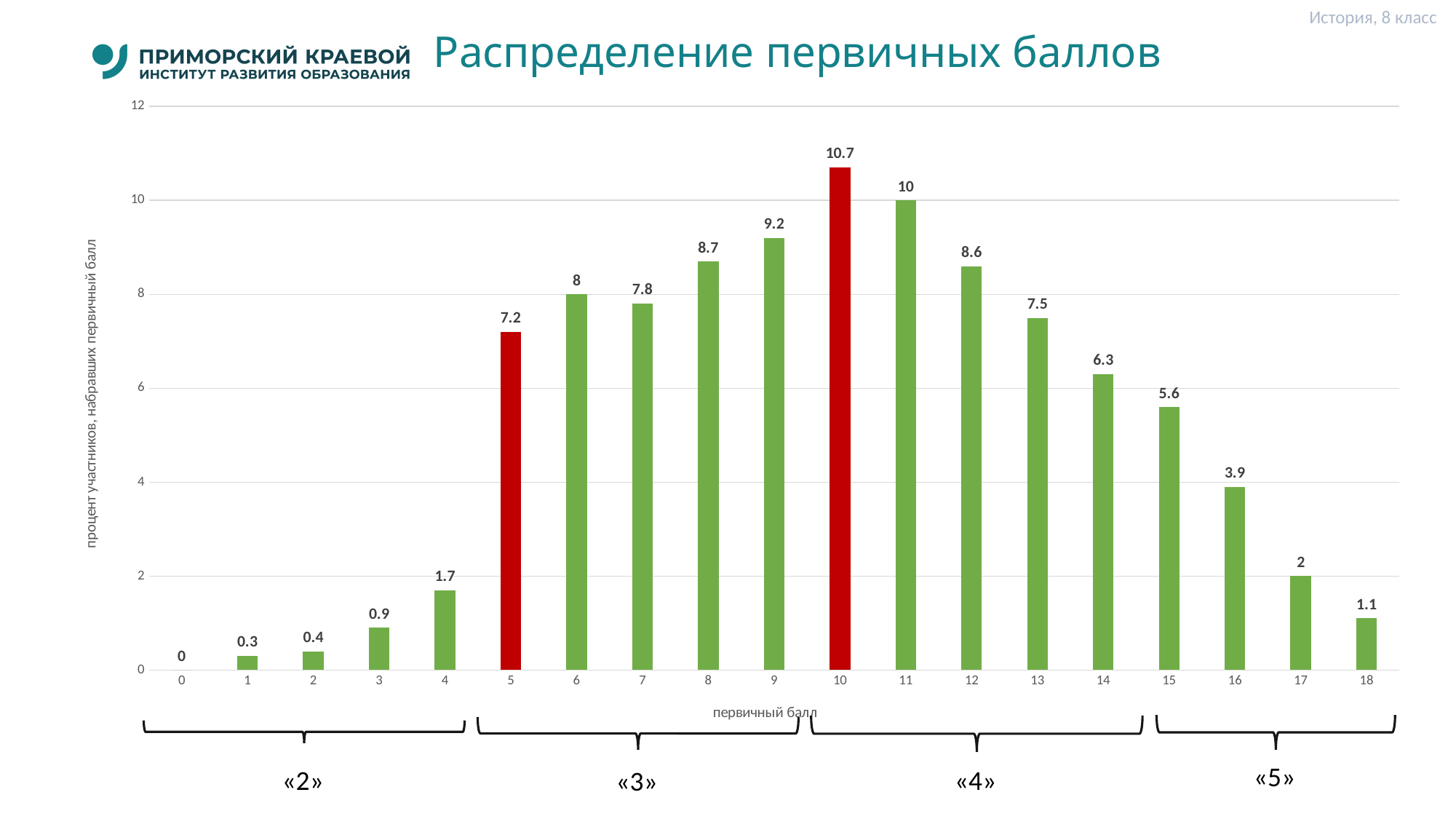
What is the difference between the values for primary scores 9 and 15? 3.6 What is the difference between the values for primary scores 10 and 11? 0.7 Which primary score has the highest percentage of participants? 10 What is the value shown for primary score 5? 7.2 Which two bars are coloured red instead of green? 5 and 10 Which primary score has the lowest percentage of participants? 0 How many primary score categories are shown on the x axis? 19 What percentage of participants scored a primary score of 10? 10.7 What type of chart is shown on the slide? bar chart Which has a larger value, primary score 8 or primary score 12? 8 Do the values rise or fall from primary score 11 to primary score 18? fall What is the value shown for primary score 16? 3.9